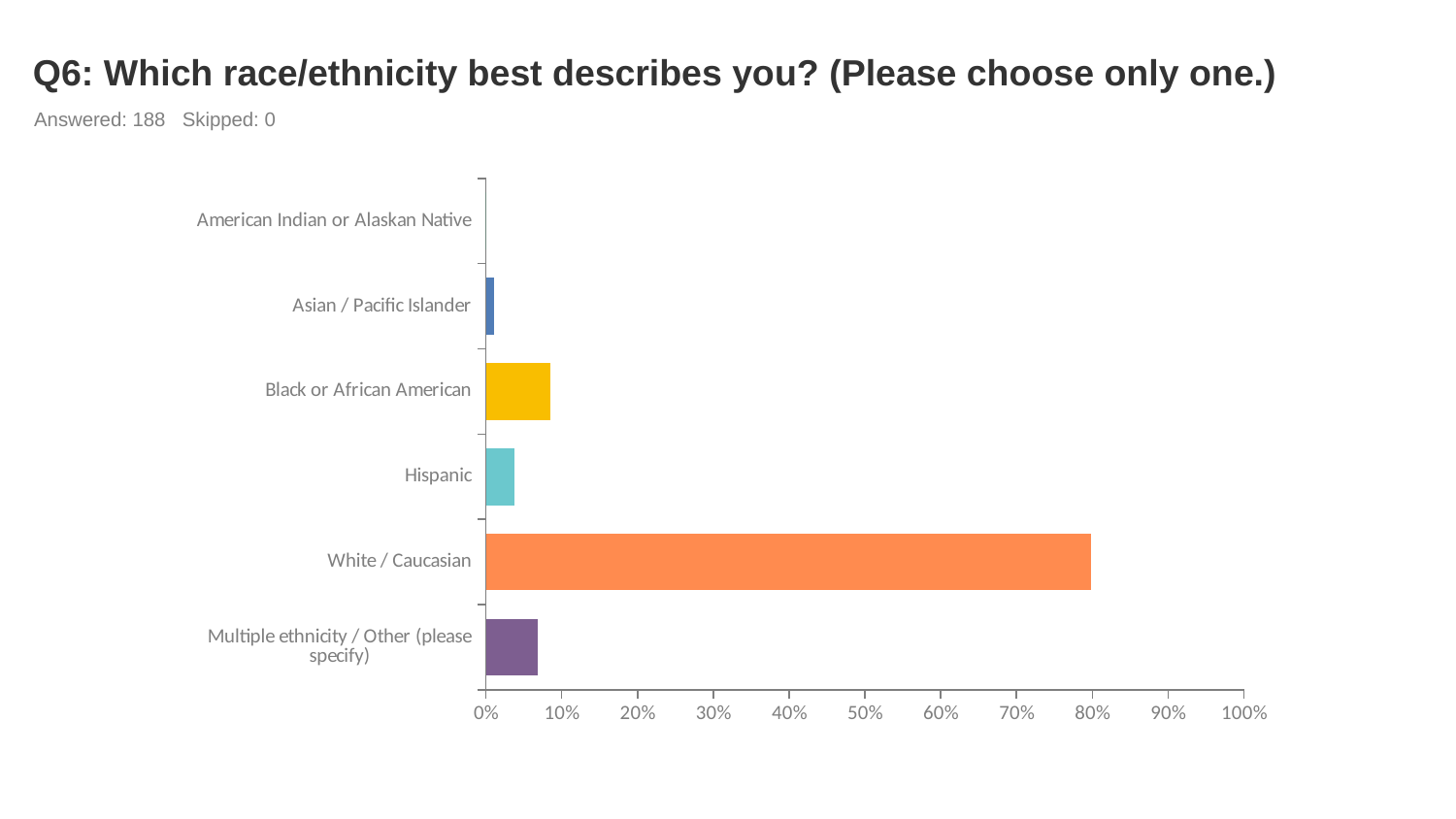
What kind of chart is shown on the slide? bar chart Is the value for Hispanic greater or less than 10%? less How many race/ethnicity categories are plotted in the chart? 6 Which category has the lowest value in the chart? American Indian or Alaskan Native Which is larger, the value for Asian / Pacific Islander or the value for Multiple ethnicity / Other (please specify)? Multiple ethnicity / Other (please specify) What is the title of the chart on the slide? Q6: Which race/ethnicity best describes you? (Please choose only one.) Is the value for White / Caucasian greater or less than 70%? greater Is the value for Black or African American greater or less than 20%? less What is the maximum value shown on the horizontal axis of the chart? 100% Which is larger, the value for Black or African American or the value for Hispanic? Black or African American Which category has the highest value in the chart? White / Caucasian